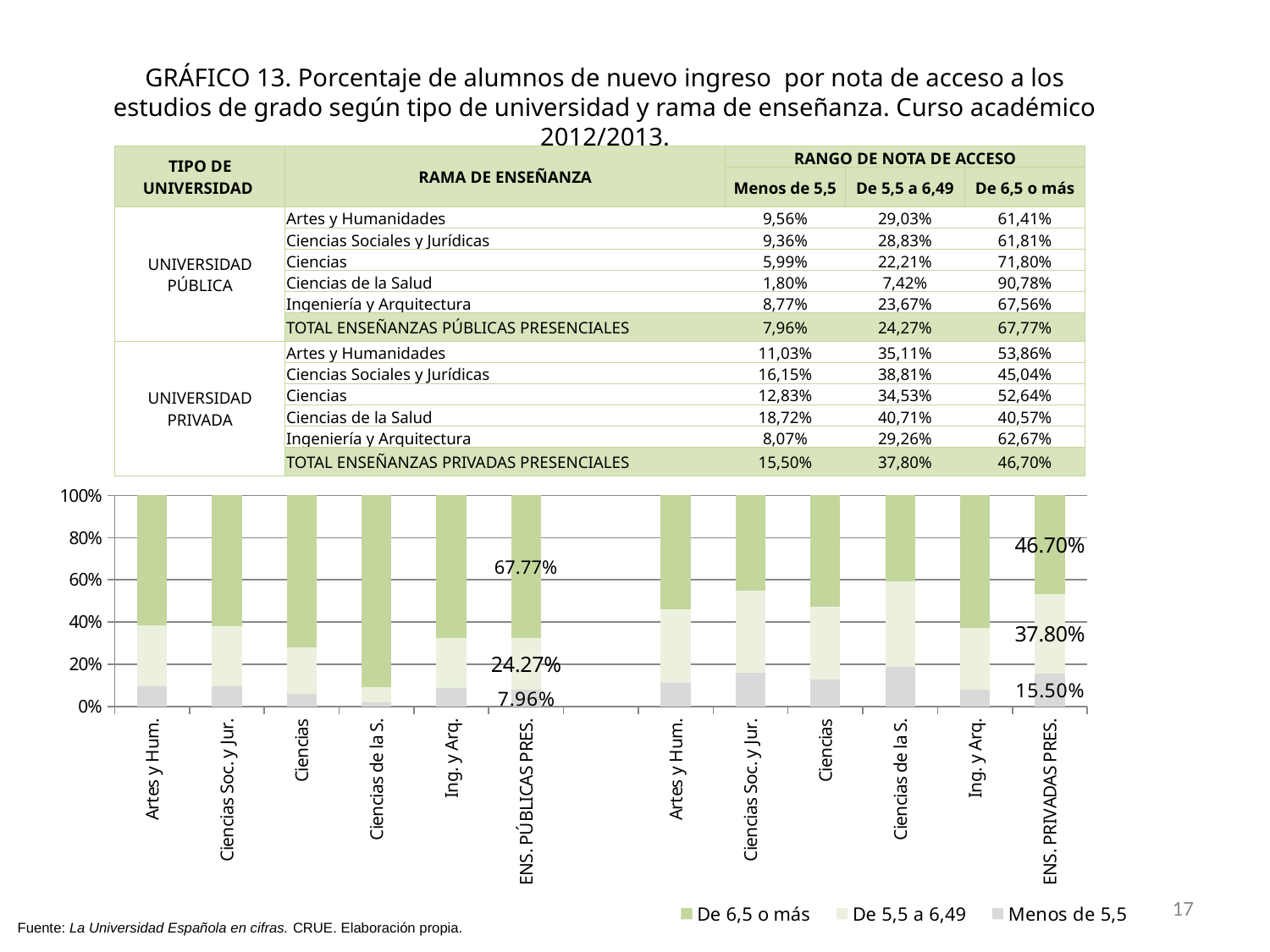
Is the 'De 6,5 o más' value for the private university Ciencias de la S. bar greater or less than 60%? less What kind of chart is shown below the table? Stacked bar chart What is the value of the 'De 5,5 a 6,49' segment for the ENS. PRIVADAS PRES. bar? 37.80% What is the value of the 'Menos de 5,5' segment for the ENS. PRIVADAS PRES. bar? 15.50% What is the value of the 'De 6,5 o más' segment for the ENS. PÚBLICAS PRES. bar? 67.77% Which bar has the largest 'De 6,5 o más' segment? Ciencias de la S. (public university) What is the difference between the 'De 6,5 o más' values for ENS. PÚBLICAS PRES. and ENS. PRIVADAS PRES.? 21.07 percentage points How many series does the chart legend list? 3 How many bars are plotted in the chart? 12 What are the three legend entries of the chart? De 6,5 o más; De 5,5 a 6,49; Menos de 5,5 Which bar has the larger 'Menos de 5,5' segment, ENS. PÚBLICAS PRES. or ENS. PRIVADAS PRES.? ENS. PRIVADAS PRES. Is the 'De 6,5 o más' value for the public university Ciencias de la S. bar greater or less than 80%? greater